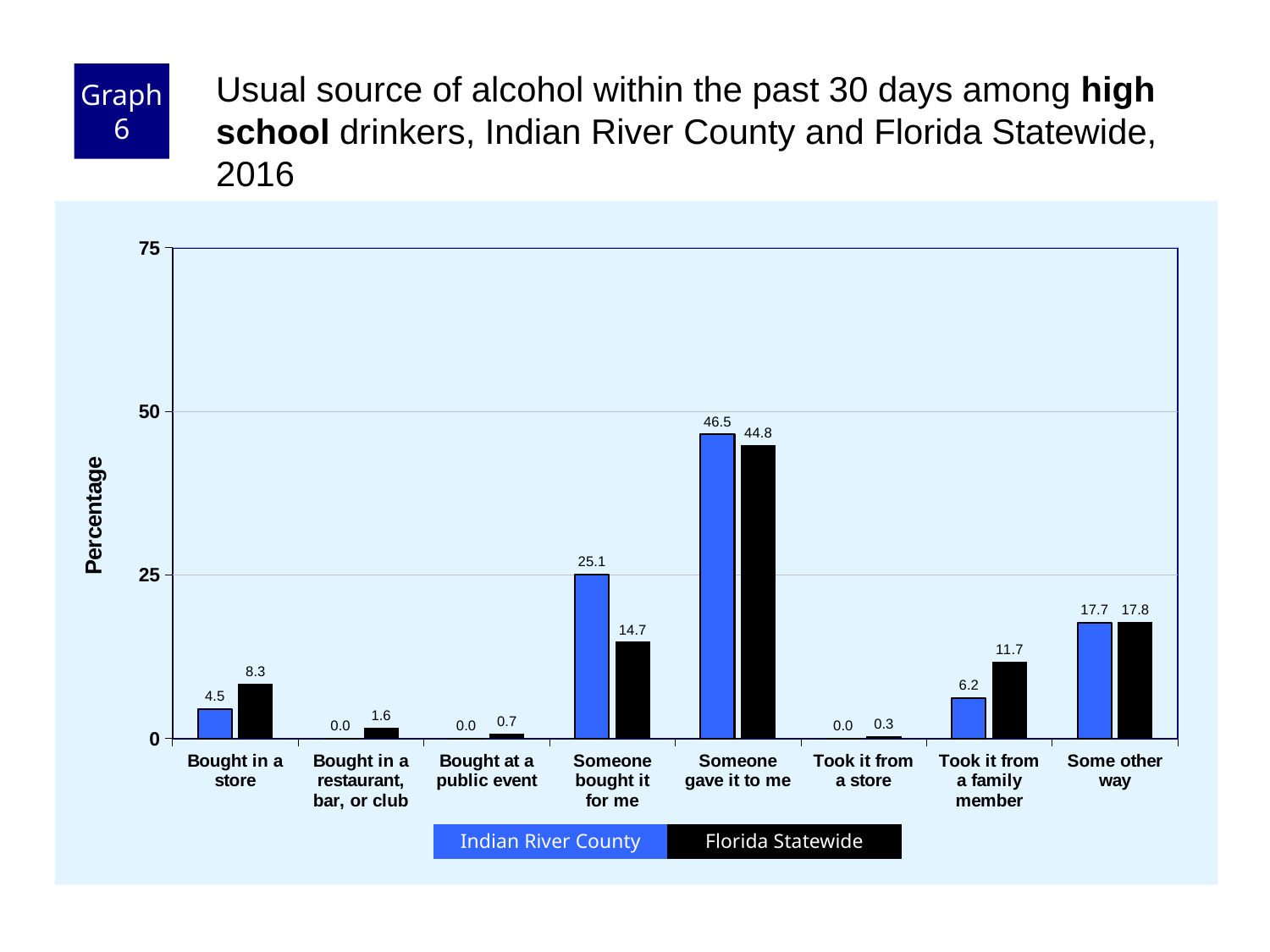
What is the Indian River County value for 'Someone gave it to me'? 46.5 What is the label of the y axis? Percentage What is the Florida Statewide value for 'Took it from a family member'? 11.7 What kind of chart is shown on the slide? bar chart Which category has the highest Indian River County value? Someone gave it to me How many series does the legend list? 2 For 'Took it from a family member', which is larger: Indian River County or Florida Statewide? Florida Statewide What is the Florida Statewide value for 'Bought in a store'? 8.3 Which category has the lowest Florida Statewide value? Took it from a store How many categories are shown on the x axis? 8 Is the Florida Statewide value for 'Someone gave it to me' greater or less than 50? less What is the difference between the Indian River County and Florida Statewide values for 'Someone bought it for me'? 10.4